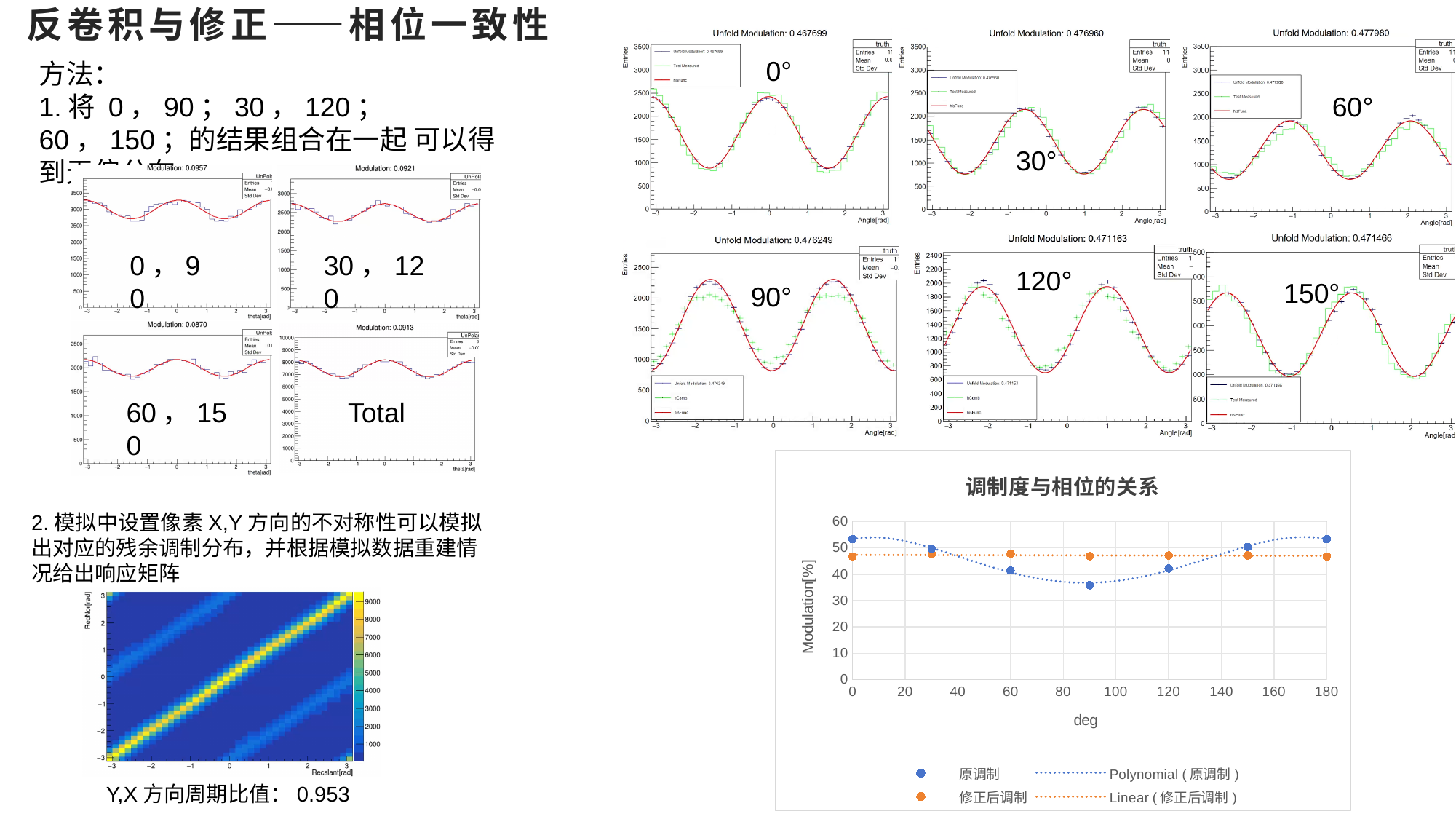
In the chart 调制度与相位的关系, what is the label of the vertical axis? Modulation[%] What kind of chart is the chart titled 调制度与相位的关系? scatter chart In the chart 调制度与相位的关系, is the 原调制 value at 90 deg greater or less than 40? less In the chart 调制度与相位的关系, is the 修正后调制 value at 120 deg greater or less than 40? greater In the chart 调制度与相位的关系, how many data points does the 原调制 series have? 7 What Modulation value is shown in the title of the plot labelled Total on the left side of the slide? 0.0913 What Unfold Modulation value is shown in the title of the 0° plot in the top row of the right-hand panel? 0.467699 In the chart 调制度与相位的关系, at which deg value is 原调制 lowest? 90 In the chart 调制度与相位的关系, at 90 deg, which series has the higher value, 原调制 or 修正后调制? 修正后调制 In the chart 调制度与相位的关系, does the 原调制 series rise or fall from 0 deg to 90 deg? fall In the chart 调制度与相位的关系, how many entries does the legend list? 4 In the chart 调制度与相位的关系, is the 原调制 value at 0 deg greater or less than 50? greater